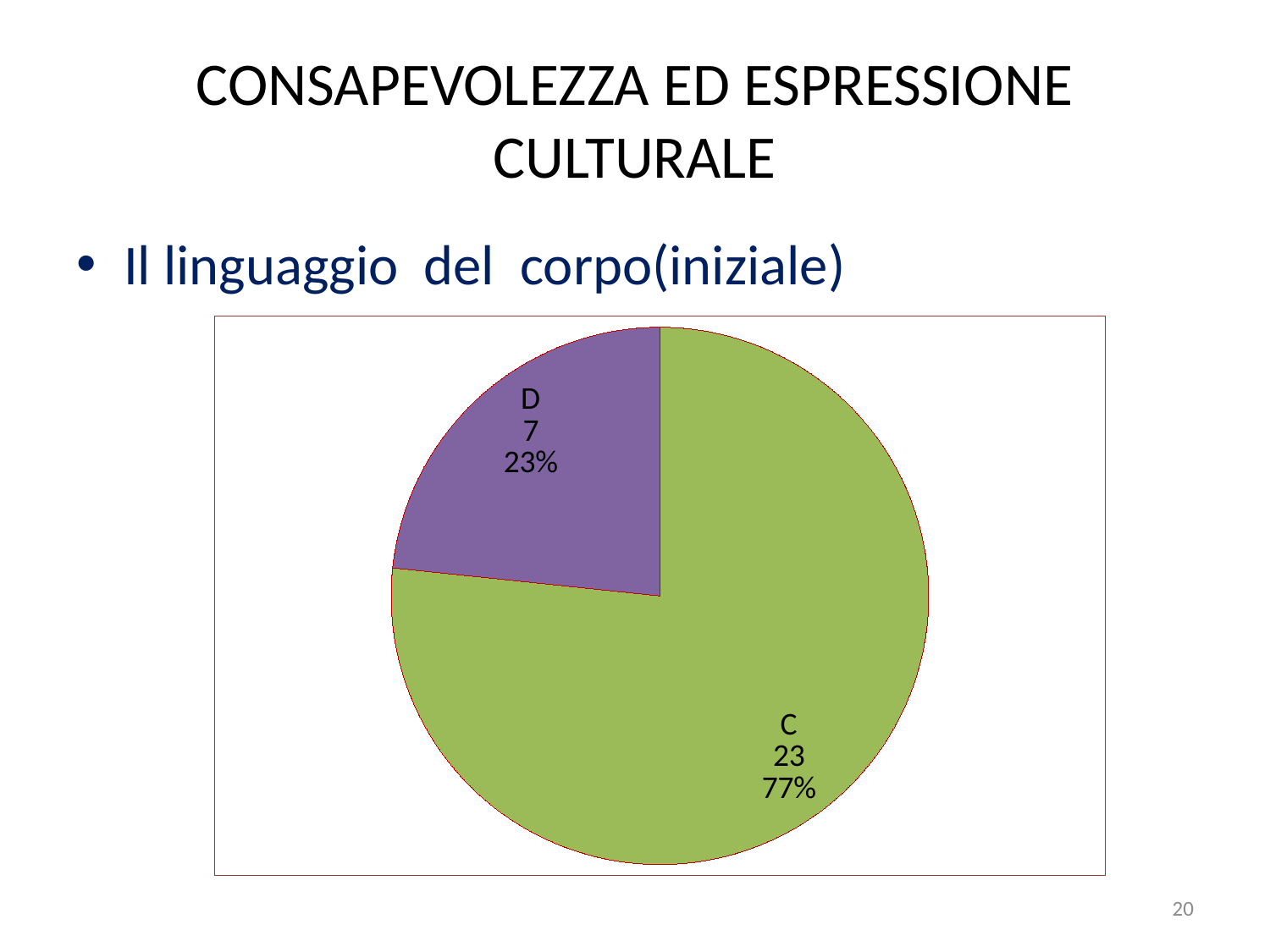
Which is larger, slice C or slice D? C What is the total of the values of all slices in the pie chart? 30 Which slice is the largest? C What is the value for slice C? 23 What is the value for slice D? 7 What kind of chart is shown on the slide? pie chart How many slices does the pie chart have? 2 What share of the pie does slice C represent? 77% What colour is slice D? purple What is the difference between the values of slice C and slice D? 16 Which slice is the smallest? D What share of the pie does slice D represent? 23%